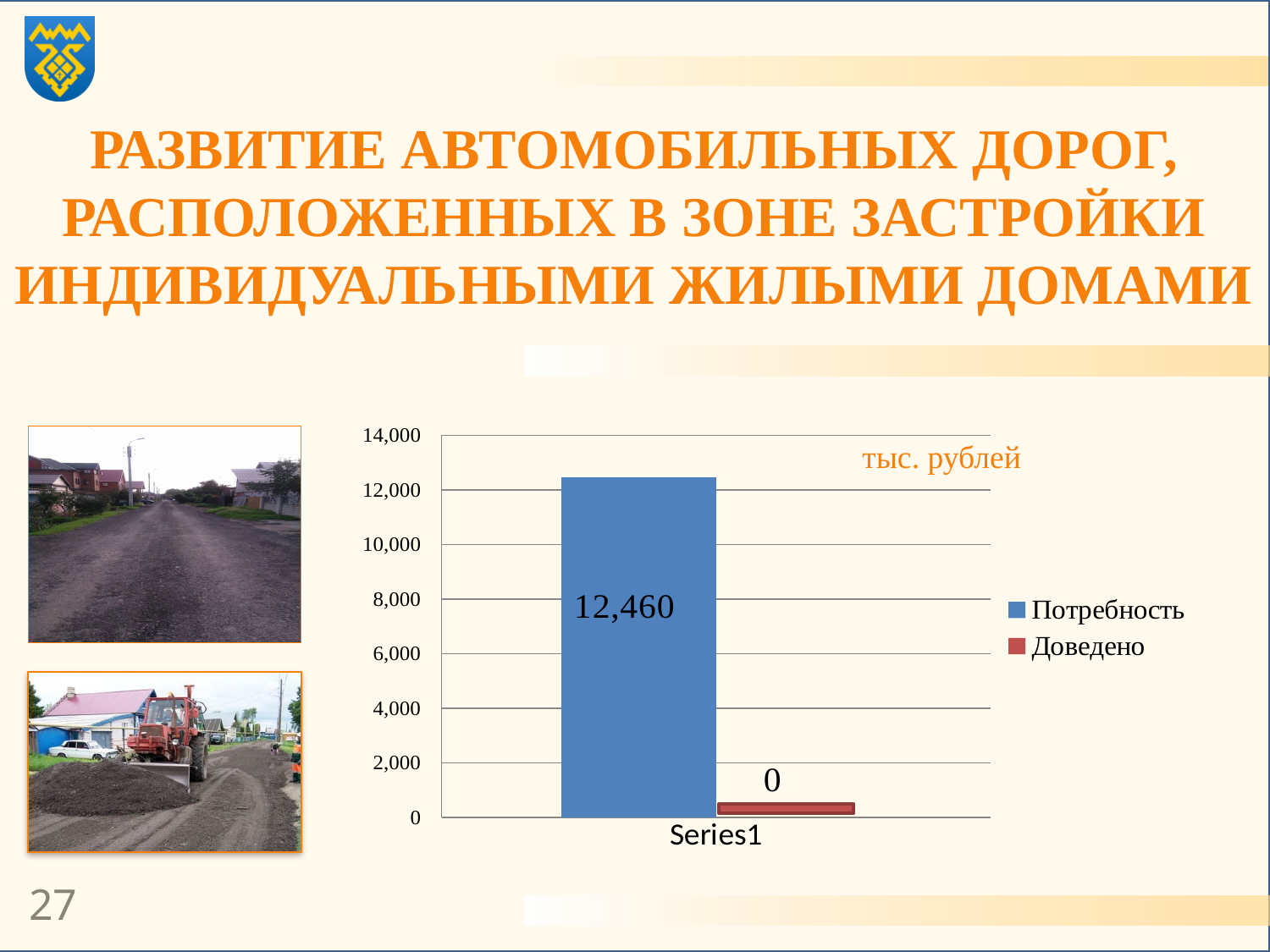
What is the value for Доведено? 0 What kind of chart is shown on the slide? bar chart What is the difference between the values for Потребность and Доведено? 12,460 Is the value for Потребность greater or less than 12,000? greater How many series does the legend list? 2 What unit is indicated on the chart? тыс. рублей Which series has the higher value, Потребность or Доведено? Потребность What is the highest value shown on the y axis? 14,000 What is the value for Потребность? 12,460 Which series has the lowest value? Доведено Is the value for Потребность greater or less than 14,000? less What is the category label shown on the x axis? Series1